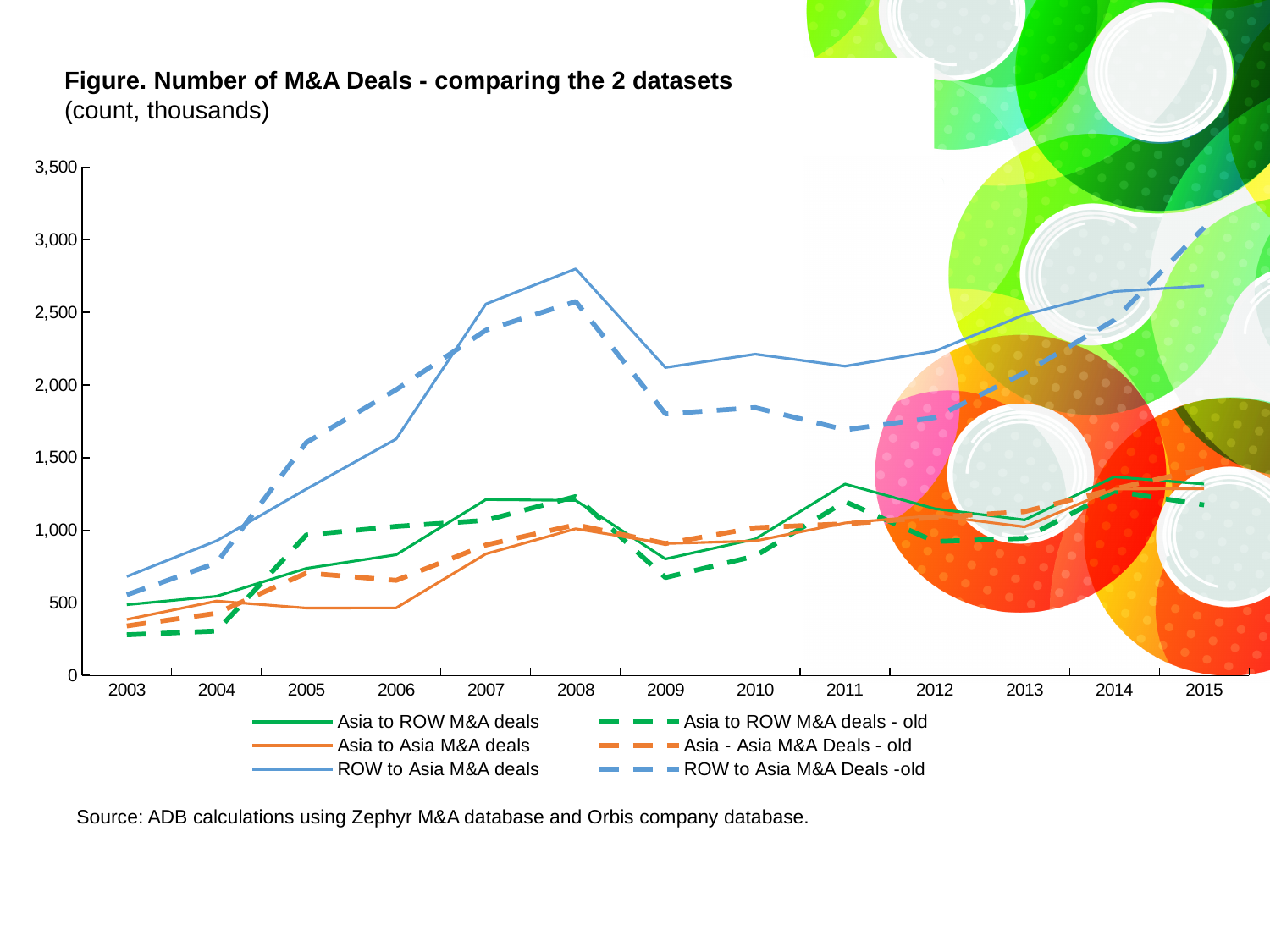
Is the value for ROW to Asia M&A deals in 2008 greater or less than 2,500? greater Do the ROW to Asia M&A deals rise or fall from 2003 to 2008? Rise How many years are shown on the x axis? 13 In 2008, which is larger: ROW to Asia M&A deals or Asia to ROW M&A deals? ROW to Asia M&A deals What kind of chart is shown on the slide? Line chart Is the value for ROW to Asia M&A Deals - old in 2015 greater or less than 3,000? greater In which year does the ROW to Asia M&A deals series (solid line) reach its highest value? 2008 What is the title of the chart? Figure. Number of M&A Deals - comparing the 2 datasets How many series does the legend list? 6 In which year is the ROW to Asia M&A deals series (solid line) at its lowest value? 2003 Is the value for Asia to ROW M&A deals - old in 2003 greater or less than 500? less